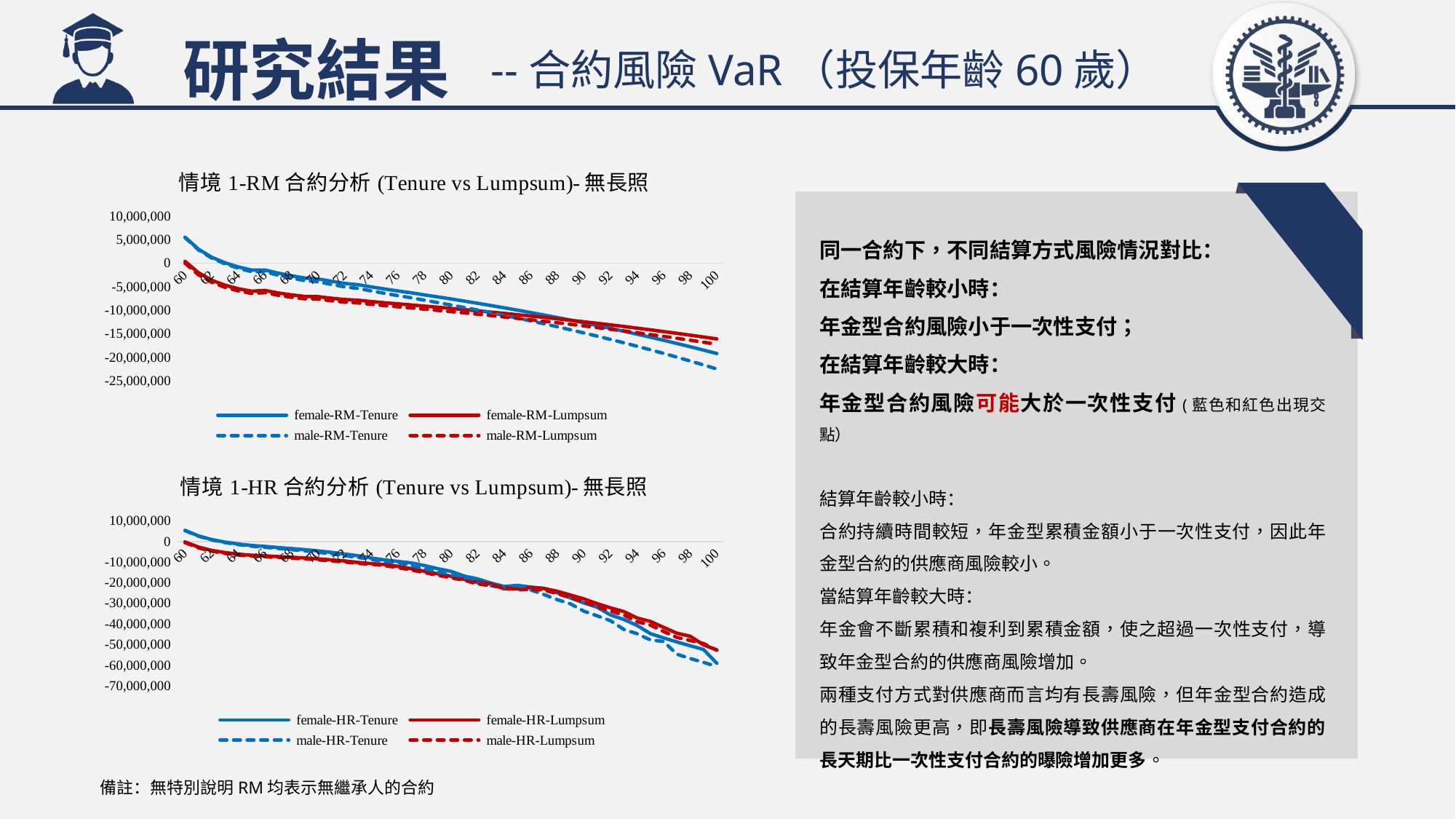
In the top chart (情境 1-RM 合約分析), is the value for male-RM-Tenure at age 100 greater or less than -20,000,000? less What type of chart is the bottom chart titled 情境 1-HR 合約分析 (Tenure vs Lumpsum)- 無長照? line chart In the bottom chart (情境 1-HR 合約分析), do the values rise or fall as age increases from 60 to 100? fall In the top chart (情境 1-RM 合約分析), is the value for female-RM-Tenure at age 60 greater or less than 0? greater In the bottom chart (情境 1-HR 合約分析), is the value for female-HR-Tenure at age 100 greater or less than -50,000,000? less In the top chart (情境 1-RM 合約分析), do the values rise or fall as age increases from 60 to 100? fall How many series does the legend of the bottom chart (情境 1-HR 合約分析) list? 4 How many series does the legend of the top chart (情境 1-RM 合約分析) list? 4 What type of chart is the top chart titled 情境 1-RM 合約分析 (Tenure vs Lumpsum)- 無長照? line chart In the top chart (情境 1-RM 合約分析), at age 100, which is higher: female-RM-Tenure or female-RM-Lumpsum? female-RM-Lumpsum What is the title of the bottom chart on the slide? 情境 1-HR 合約分析 (Tenure vs Lumpsum)- 無長照 In the top chart (情境 1-RM 合約分析), which series is drawn as a dashed red line? male-RM-Lumpsum